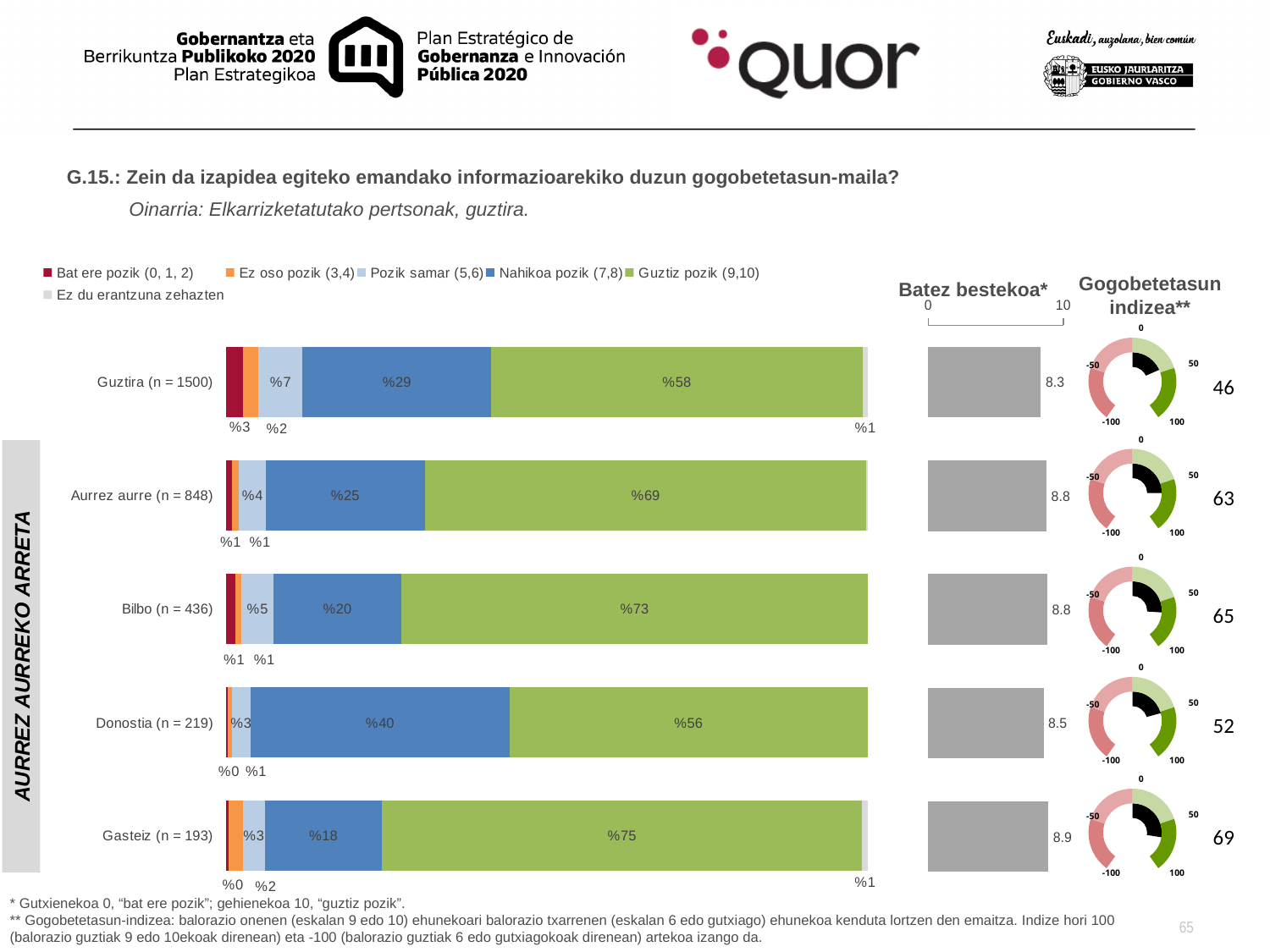
In the stacked bar chart, which category has the highest "Guztiz pozik (9,10)" value? Gasteiz (n = 193) In the stacked bar chart, what is the value of "Nahikoa pozik (7,8)" for Donostia (n = 219)? %40 In the "Gogobetetasun indizea**" gauges, which category has the highest index value? Gasteiz (n = 193) In the stacked bar chart, what is the value of "Guztiz pozik (9,10)" for Bilbo (n = 436)? %73 In the "Gogobetetasun indizea**" gauges, what is the index value for Donostia (n = 219)? 52 In the stacked bar chart, which has the larger "Nahikoa pozik (7,8)" value: Guztira (n = 1500) or Aurrez aurre (n = 848)? Guztira (n = 1500) In the stacked bar chart, what is the difference between the "Guztiz pozik (9,10)" values for Gasteiz (n = 193) and Guztira (n = 1500)? 17 percentage points In the "Batez bestekoa*" chart, what is the value for Gasteiz (n = 193)? 8.9 How many series does the legend of the stacked bar chart list? 6 In the stacked bar chart, which category has the lowest "Guztiz pozik (9,10)" value? Donostia (n = 219) How many categories (rows) does the stacked bar chart show? 5 What kind of chart is the main chart on the slide? Stacked bar chart